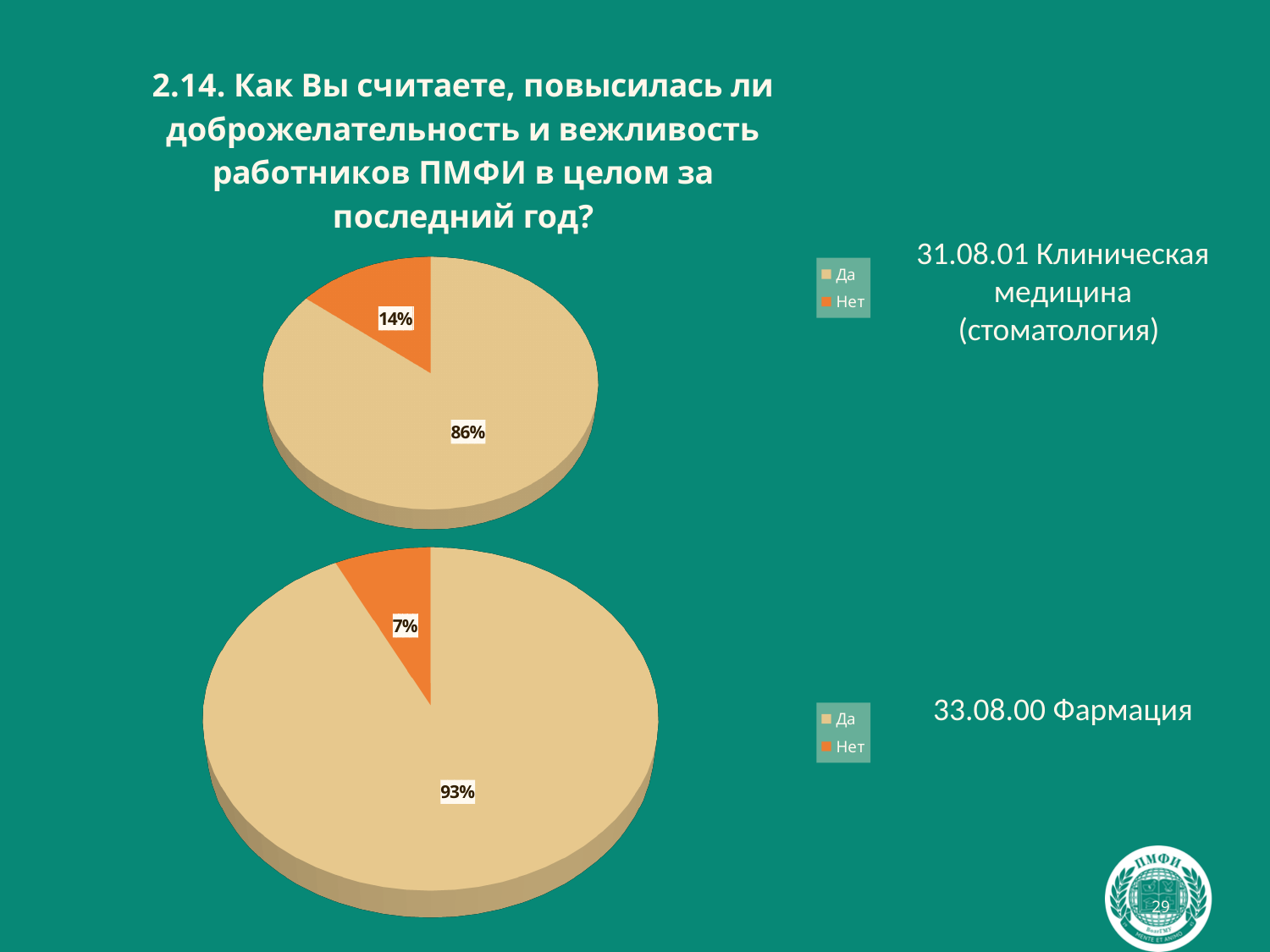
In the top pie chart (31.08.01 Клиническая медицина (стоматология)), what share of respondents answered "Да"? 86% Which chart has the larger "Нет" share: the top chart (31.08.01 Клиническая медицина (стоматология)) or the bottom chart (33.08.00 Фармация)? The top chart (31.08.01 Клиническая медицина (стоматология)) In the top pie chart (31.08.01 Клиническая медицина (стоматология)), which answer has the largest slice? Да In the bottom pie chart (33.08.00 Фармация), what colour is the "Нет" slice? Orange What type of chart is used for the bottom chart (33.08.00 Фармация)? Pie chart In the bottom pie chart (33.08.00 Фармация), which answer has the smallest slice? Нет In the top pie chart (31.08.01 Клиническая медицина (стоматология)), what share of respondents answered "Нет"? 14% In the bottom pie chart (33.08.00 Фармация), what share of respondents answered "Нет"? 7% How many entries does the legend of the bottom pie chart (33.08.00 Фармация) list? 2 In the bottom pie chart (33.08.00 Фармация), what share of respondents answered "Да"? 93% In the top pie chart (31.08.01 Клиническая медицина (стоматология)), what is the difference between the "Да" and "Нет" shares? 72% How many slices does the top pie chart (31.08.01 Клиническая медицина (стоматология)) have? 2